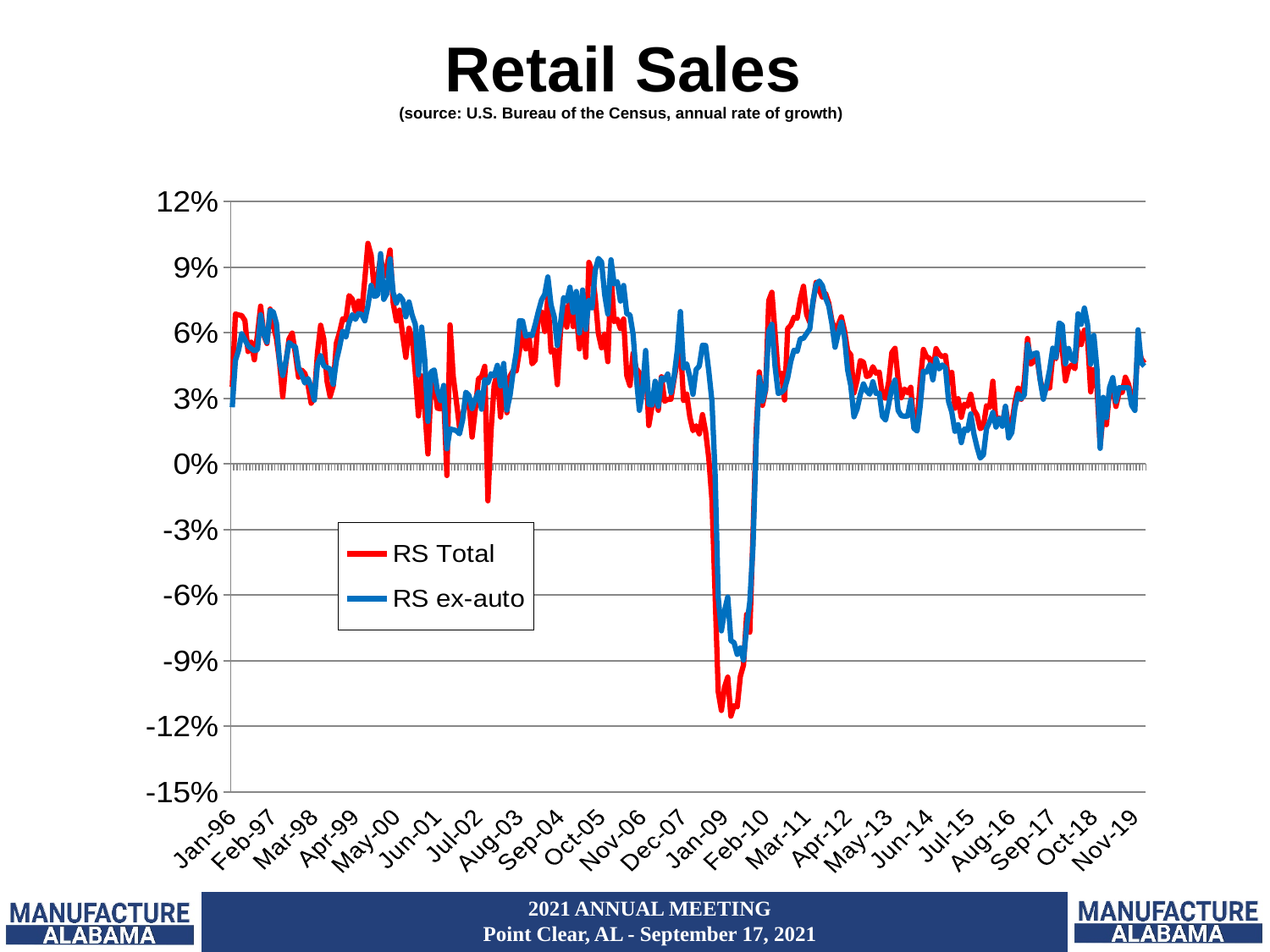
Is the value of RS Total at Nov-19 greater or less than 0%? greater What kind of chart is shown on the slide? line chart Around Jan-09, which series has the lower value, RS Total or RS ex-auto? RS Total Is the lowest value of RS Total greater or less than -9%? less What is the title of the chart? Retail Sales Do the values of RS Total rise or fall between Dec-07 and Jan-09? fall Is the highest value of RS ex-auto greater or less than 6%? greater Which colour is used for the RS ex-auto series? blue How many series does the legend list? 2 Which series reaches the lowest value on the chart, around Jan-09? RS Total How many date labels are shown on the x axis? 23